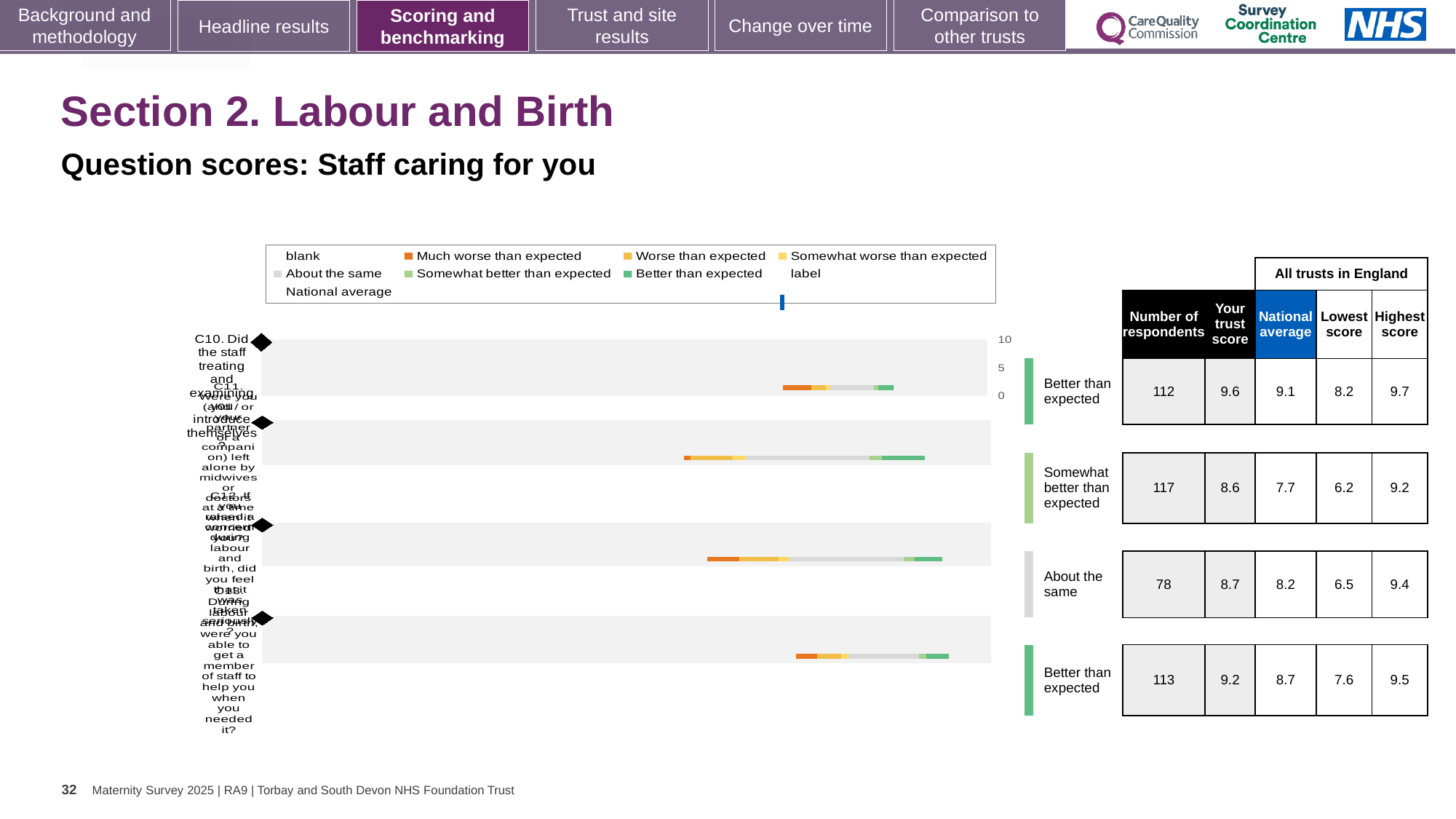
Which row in the table has the highest 'Your trust score'? the first (top) row Which has more respondents, the first row or the third row? the first row In the table next to the chart, what is the 'Your trust score' value for the second row? 8.6 For the second row, what is the difference between 'Your trust score' and the national average? 0.9 What kind of chart is shown on the slide? bar chart Is the 'Your trust score' for the fourth (bottom) row greater or less than 9? greater How many question rows (bars) are plotted in the chart? 4 Which row in the table has the lowest value in the 'Lowest score' column? the second row In the table next to the chart, what is the national average for the third row? 8.2 What benchmark category label is shown for the third row? About the same In the table next to the chart, what is the number of respondents for the first (top) row? 112 In the table next to the chart, what is the highest score for the fourth (bottom) row? 9.5